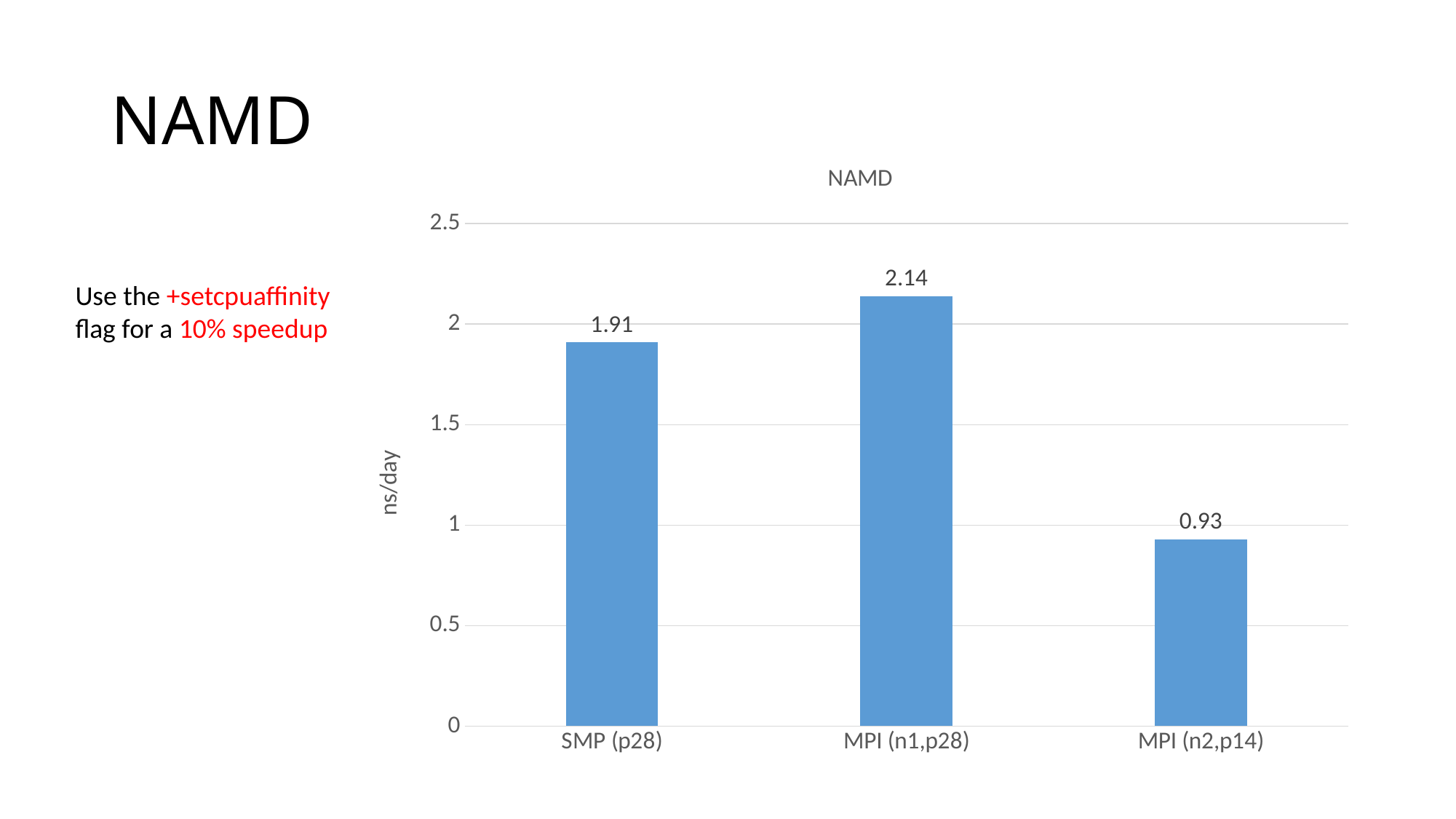
Which is larger, the value for SMP (p28) or the value for MPI (n2,p14)? SMP (p28) What kind of chart is this? bar chart What is the value for MPI (n2,p14)? 0.93 What is the difference between the values for MPI (n1,p28) and SMP (p28)? 0.23 Which category has the lowest value? MPI (n2,p14) How many categories are shown on the x axis? 3 What is the value for MPI (n1,p28)? 2.14 Which category has the highest value? MPI (n1,p28) What is the value for SMP (p28)? 1.91 Is the value for MPI (n1,p28) greater or less than 2? greater What is the label of the y axis? ns/day What is the difference between the values for SMP (p28) and MPI (n2,p14)? 0.98